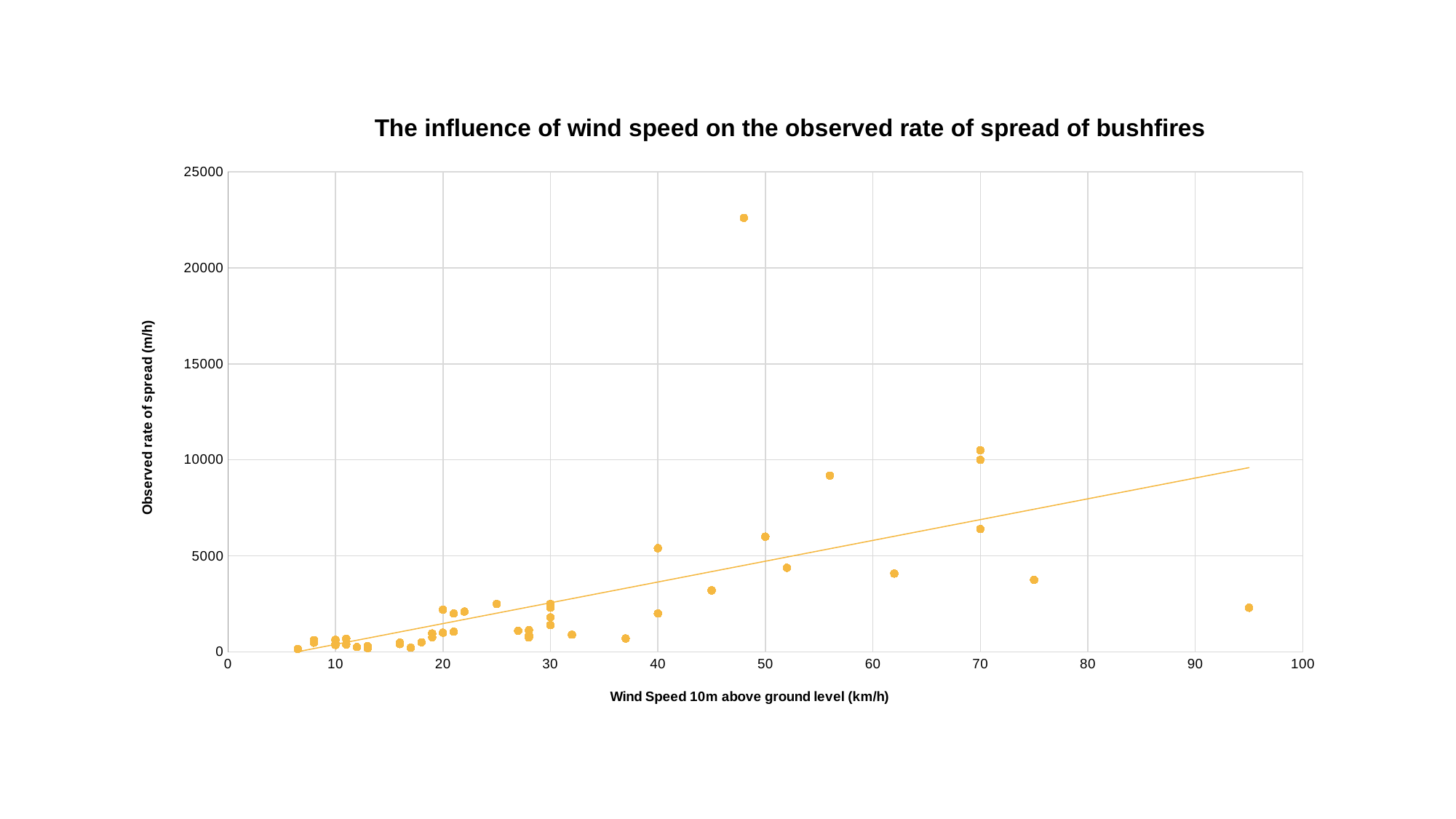
Is the observed rate of spread for the point at 45 km/h greater or less than 5000? less What is the title of the chart? The influence of wind speed on the observed rate of spread of bushfires Is the highest observed rate of spread on the chart greater or less than 20000 m/h? greater Is the observed rate of spread for the point at 62 km/h greater or less than 5000? less What kind of chart is shown on the slide? scatter chart Which has the higher observed rate of spread: the point at 56 km/h or the point at 95 km/h? 56 km/h Does the trend line rise or fall as wind speed increases? rises What is the label of the x axis? Wind Speed 10m above ground level (km/h)